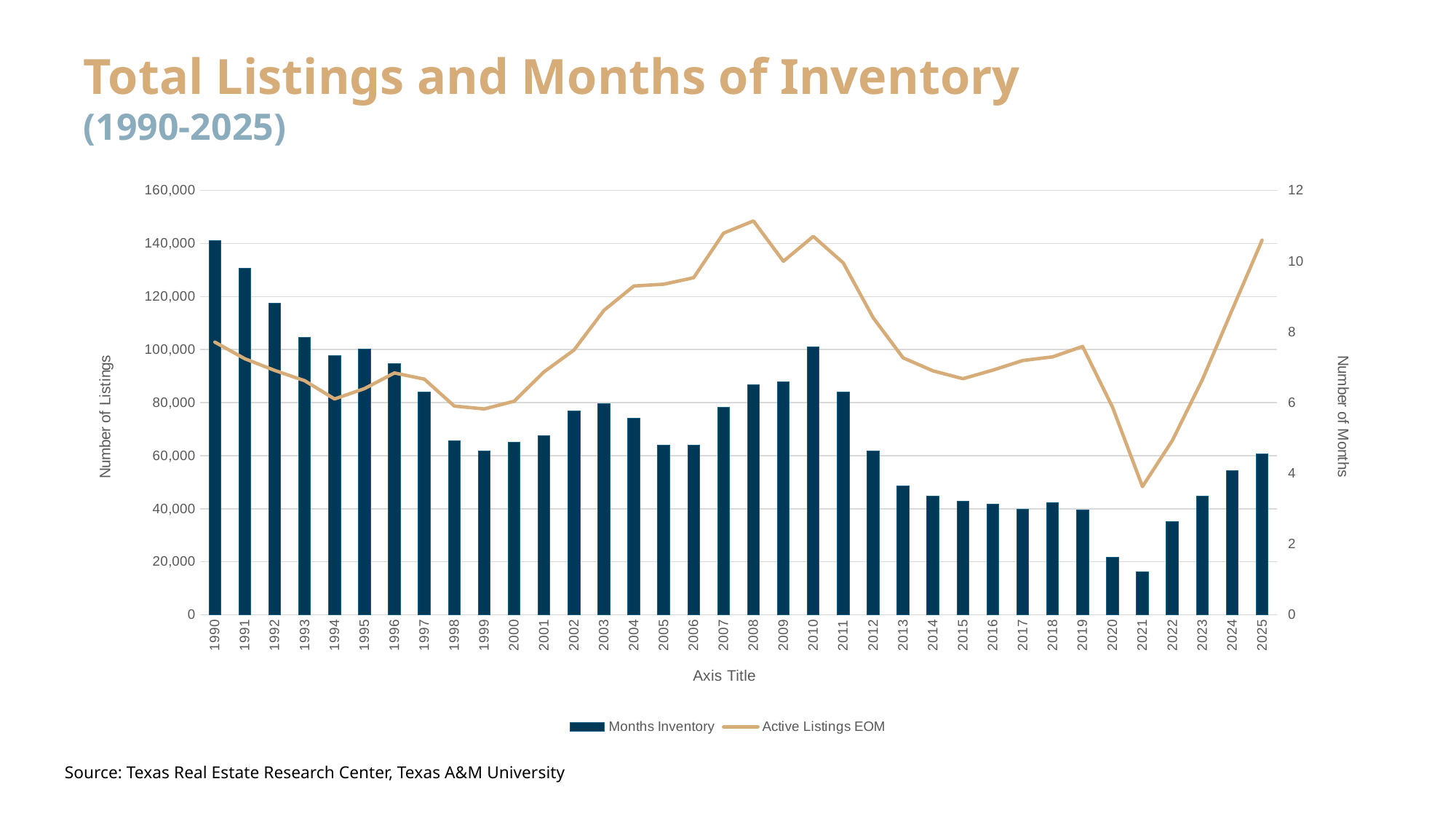
Is the Months Inventory bar for 1990 greater or less than 120,000 on the left axis? greater Is the Active Listings EOM line for 2008 greater or less than 10 on the right axis? greater Which year has the shortest bar for Months Inventory? 2021 How many years are shown along the x axis? 36 In which year does the Active Listings EOM line reach its highest point? 2008 In which year does the Active Listings EOM line reach its lowest point? 2021 Which year has the tallest bar for Months Inventory? 1990 Which year has the taller Months Inventory bar, 2023 or 2024? 2024 Do the Months Inventory bars rise or fall from 1990 to 1999? fall How many series does the legend list? 2 Is the Months Inventory bar for 2021 greater or less than 20,000 on the left axis? less What kind of chart is shown on the slide? A combination bar and line chart